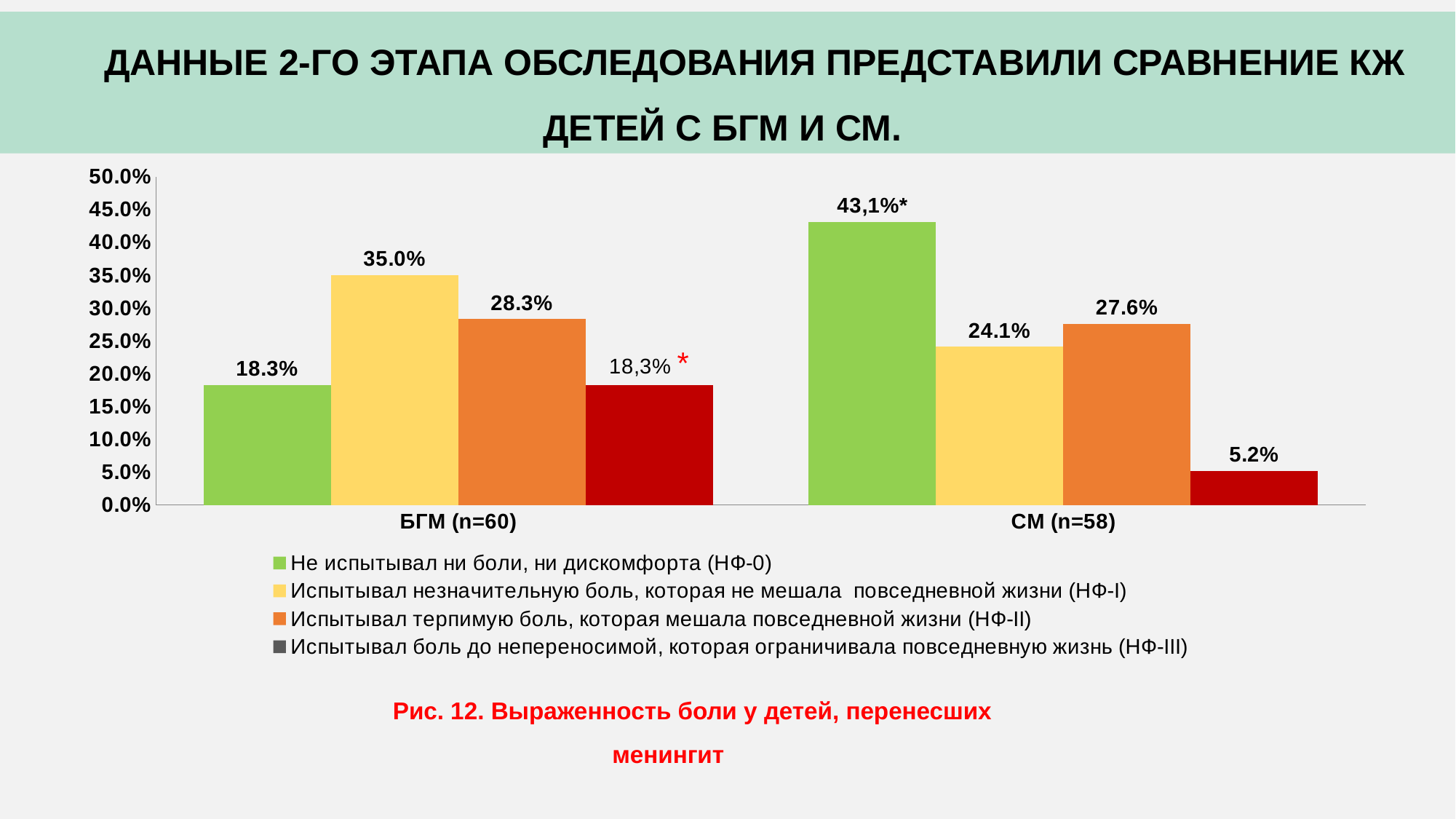
What is the value for НФ-0 (no pain or discomfort) in the СМ (n=58) group? 43,1% What is the value for НФ-II (tolerable pain) in the СМ (n=58) group? 27.6% Which pain level has the highest value in the БГМ (n=60) group? НФ-I How many series does the legend list? 4 Which group has the larger value for НФ-0: БГМ (n=60) or СМ (n=58)? СМ (n=58) What is the difference between the НФ-I and НФ-0 values in the БГМ (n=60) group? 16.7% What is the value for НФ-III (pain up to unbearable) in the СМ (n=58) group? 5.2% How many groups are shown on the x axis? 2 What is the value for НФ-I (minor pain) in the БГМ (n=60) group? 35.0% What is the value for НФ-0 (no pain or discomfort) in the БГМ (n=60) group? 18.3% What kind of chart is shown on the slide? bar chart Which pain level has the lowest value in the СМ (n=58) group? НФ-III